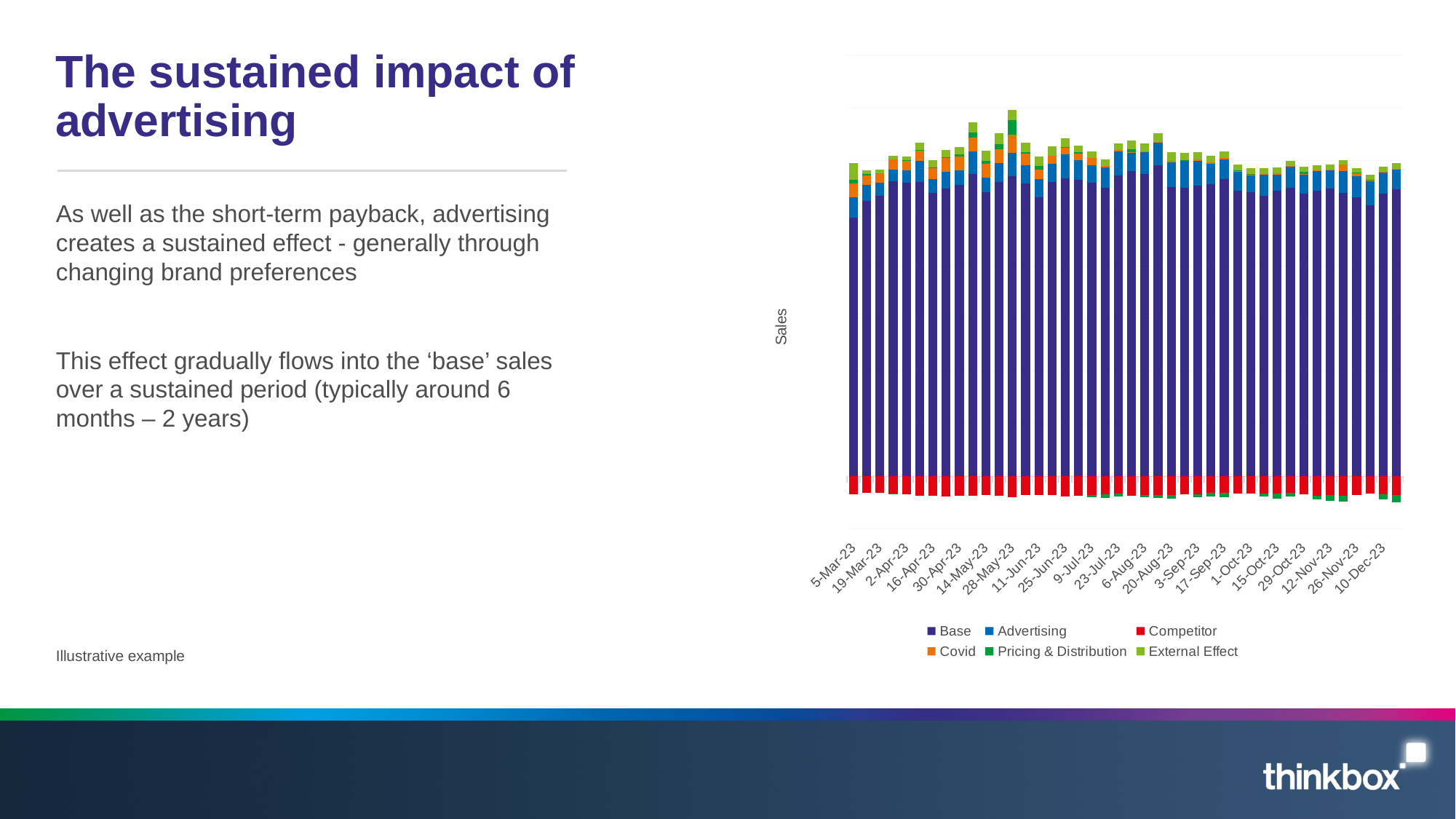
How many date labels are shown along the x axis of the chart? 21 What is the label on the vertical axis of the chart? Sales What kind of chart is shown on the slide? Stacked bar chart Around which x-axis date label is the tallest stacked bar? 28-May-23 What is the last date label on the x axis of the chart? 10-Dec-23 Which series in the legend is plotted in red? Competitor What is the first date label on the x axis of the chart? 5-Mar-23 How many series does the chart legend list? 6 Which series makes up the largest part of each stacked bar? Base